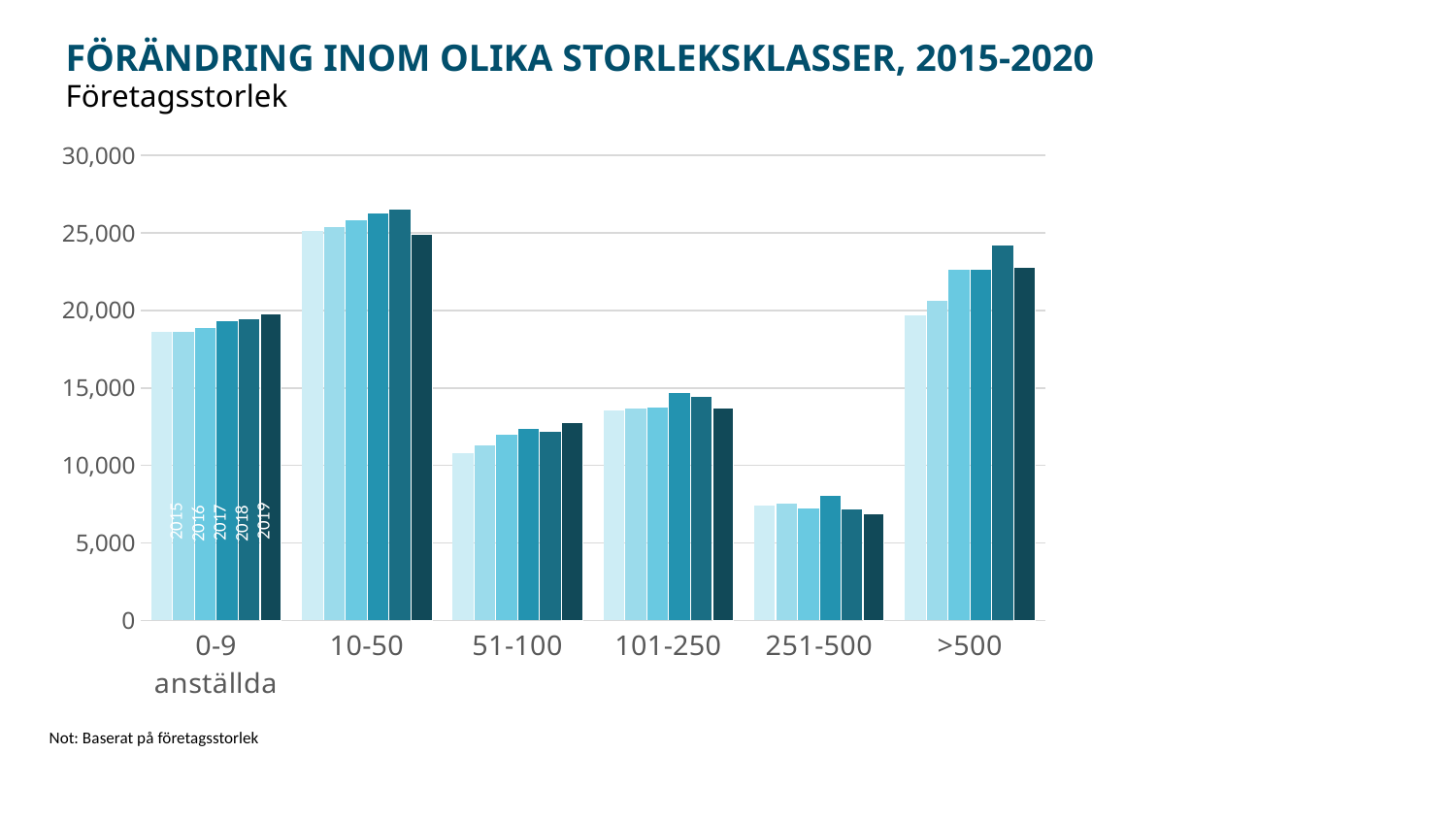
Which category has larger values, 10-50 or >500? 10-50 Is the 2015 value for the 51-100 category greater or less than 15,000? less Is the 2015 value for the 10-50 category greater or less than 20,000? greater How many company size categories are shown on the x axis? 6 Is the 2019 value for the >500 category greater or less than 20,000? greater What kind of chart is shown on the slide? bar chart What is the title of the chart? FÖRÄNDRING INOM OLIKA STORLEKSKLASSER, 2015-2020 Which company size category has the lowest bars? 251-500 Which company size category has the highest bars? 10-50 How many bars are there in each category group? 6